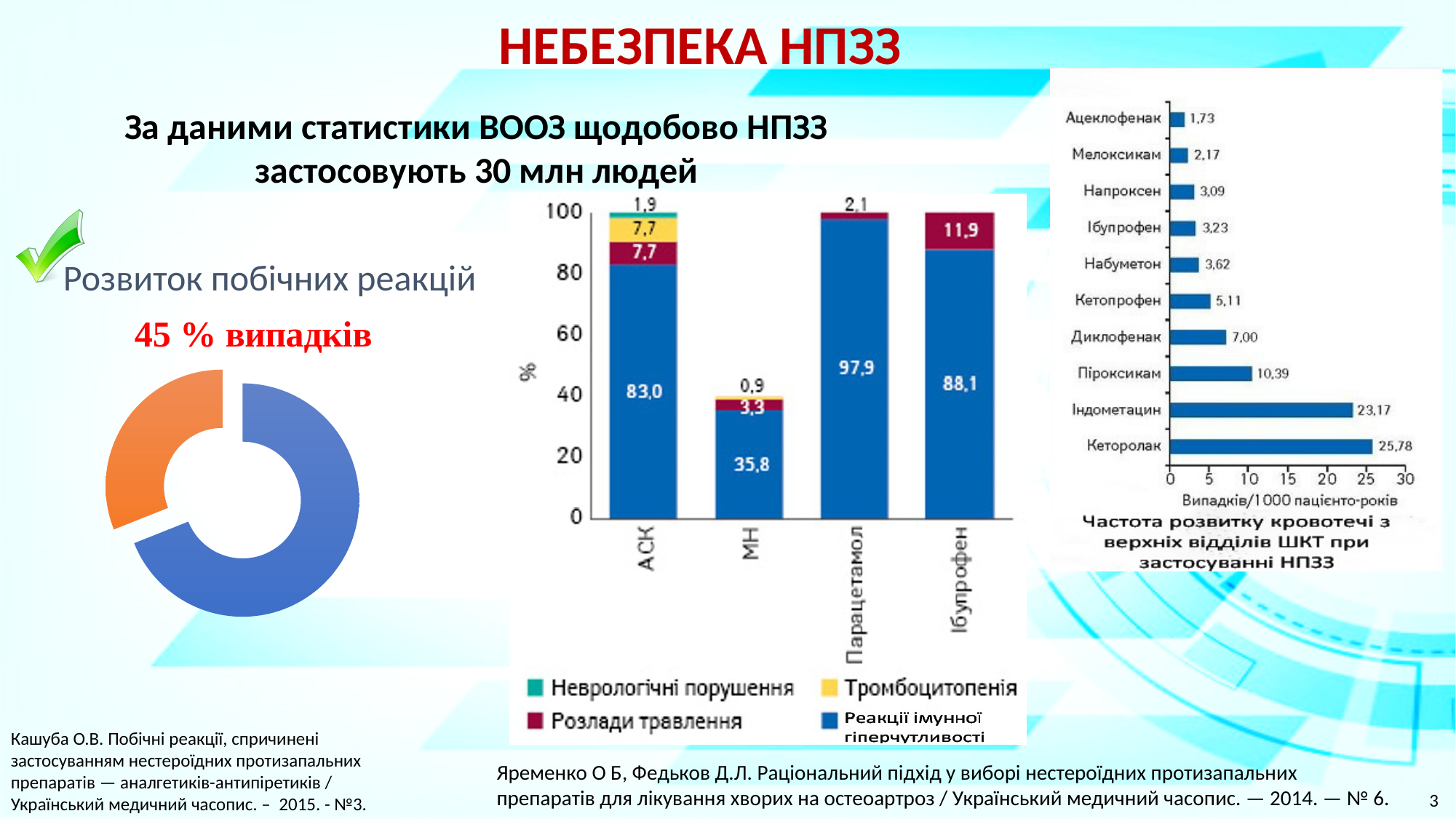
In the chart titled 'Частота розвитку кровотечі з верхніх відділів ШКТ при застосуванні НПЗЗ', what is the value for Кеторолак? 25,78 In the middle stacked bar chart, what is the value of 'Розлади травлення' for Ібупрофен? 11,9 In the middle stacked bar chart, what is the value of 'Реакції імунної гіперчутливості' for Парацетамол? 97,9 In the chart titled 'Частота розвитку кровотечі з верхніх відділів ШКТ при застосуванні НПЗЗ', which is larger: Диклофенак or Кетопрофен? Диклофенак What kind of chart is shown on the left side of the slide below '45 % випадків'? Doughnut chart In the chart titled 'Частота розвитку кровотечі з верхніх відділів ШКТ при застосуванні НПЗЗ', which drug has the highest value? Кеторолак In the chart titled 'Частота розвитку кровотечі з верхніх відділів ШКТ при застосуванні НПЗЗ', what kind of chart is shown? Bar chart In the chart titled 'Частота розвитку кровотечі з верхніх відділів ШКТ при застосуванні НПЗЗ', what is the difference between Індометацин and Піроксикам? 12,78 In the chart titled 'Частота розвитку кровотечі з верхніх відділів ШКТ при застосуванні НПЗЗ', which drug has the lowest value? Ацеклофенак In the chart titled 'Частота розвитку кровотечі з верхніх відділів ШКТ при застосуванні НПЗЗ', how many drugs are listed? 10 In the middle stacked bar chart, what is the total of the МН bar? 40,0 In the middle stacked bar chart, how many series does the legend list? 4